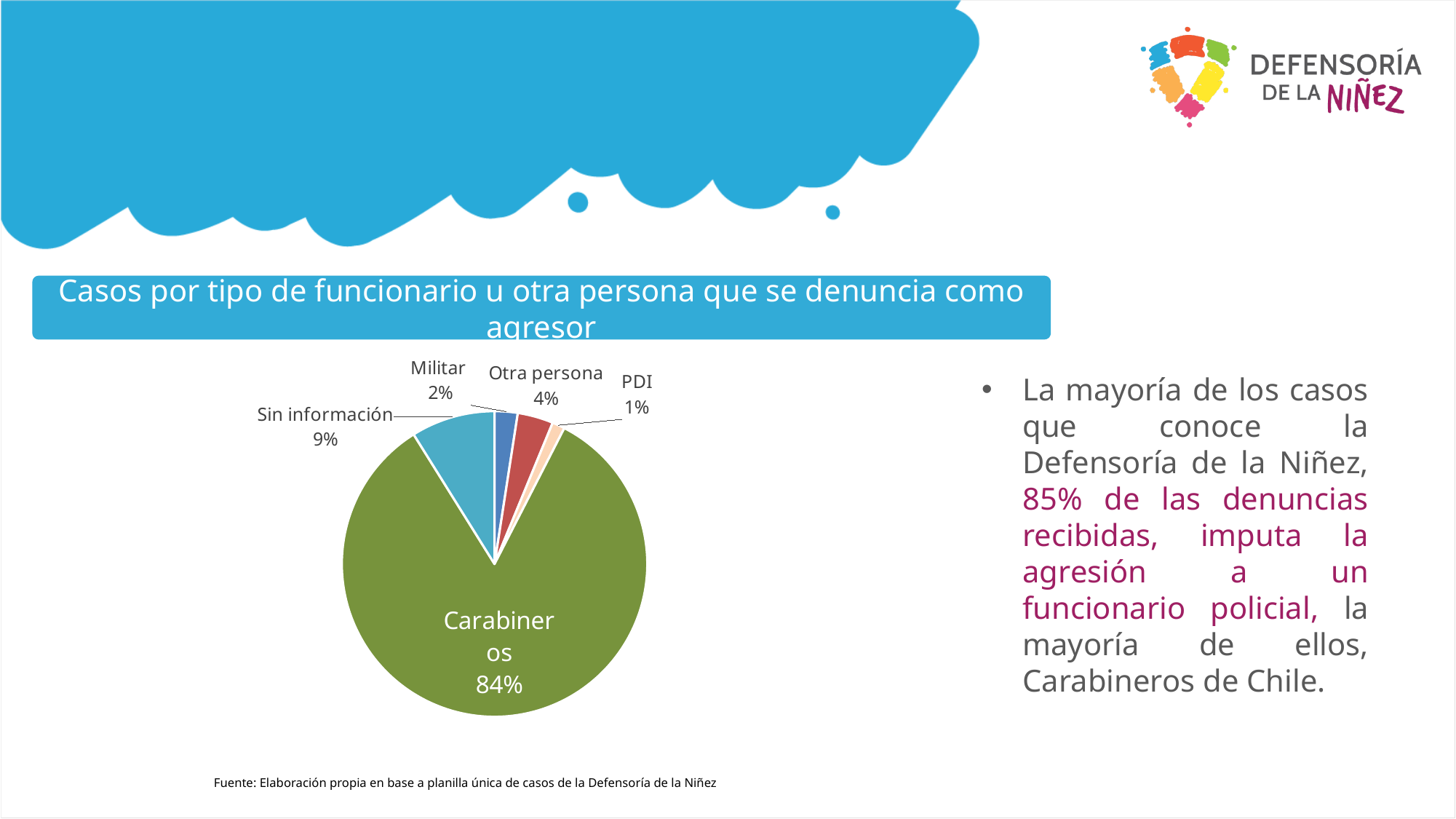
What percentage is shown for Otra persona? 4% What percentage is shown for Sin información? 9% How many categories are shown in the pie chart? 5 Which category has the smallest slice of the pie? PDI What percentage is shown for Militar? 2% Which is larger, the share for Militar or the share for Otra persona? Otra persona What is the title of the chart? Casos por tipo de funcionario u otra persona que se denuncia como agresor Which category has the largest slice of the pie? Carabineros What is the difference in percentage points between Sin información and Otra persona? 5% What share of the pie does Carabineros represent? 84% What percentage is shown for PDI? 1% What type of chart is shown on the slide? Pie chart